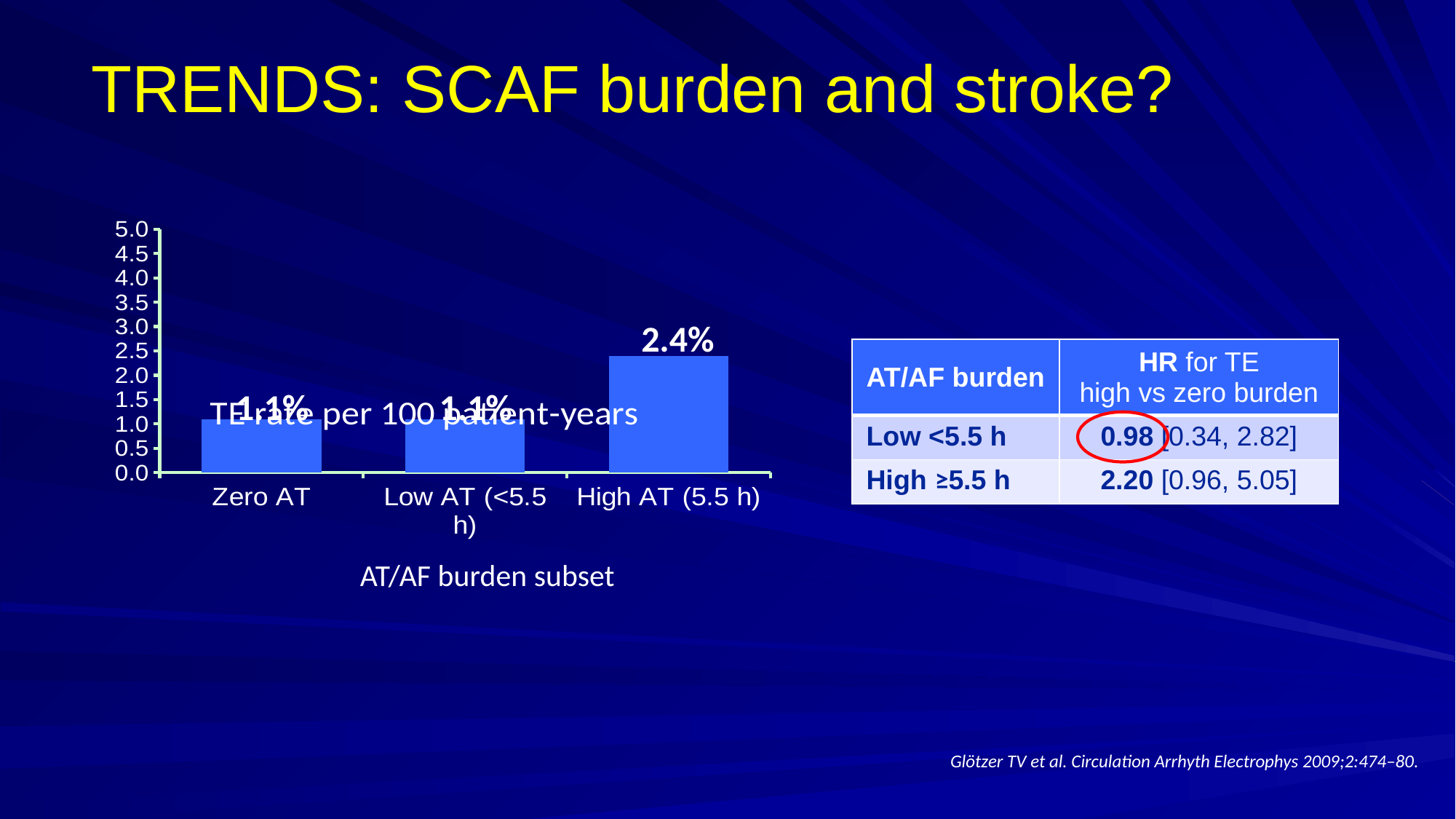
What kind of chart is shown on the slide? Bar chart What is the x-axis title of the chart? AT/AF burden subset Which has a larger TE rate, High AT (5.5 h) or Low AT (<5.5 h)? High AT (5.5 h) What is the TE rate for the Zero AT category? 1.1% Which AT/AF burden subset has the highest TE rate? High AT (5.5 h) What is the TE rate for the High AT (5.5 h) category? 2.4% Is the value for Zero AT greater or less than 1.5? less How many AT/AF burden subsets are plotted in the chart? 3 Is the value for High AT (5.5 h) greater or less than 2.0? greater What is the difference in TE rate between High AT (5.5 h) and Zero AT? 1.3% What is the maximum value shown on the chart's y-axis? 5.0 What is the TE rate for the Low AT (<5.5 h) category? 1.1%